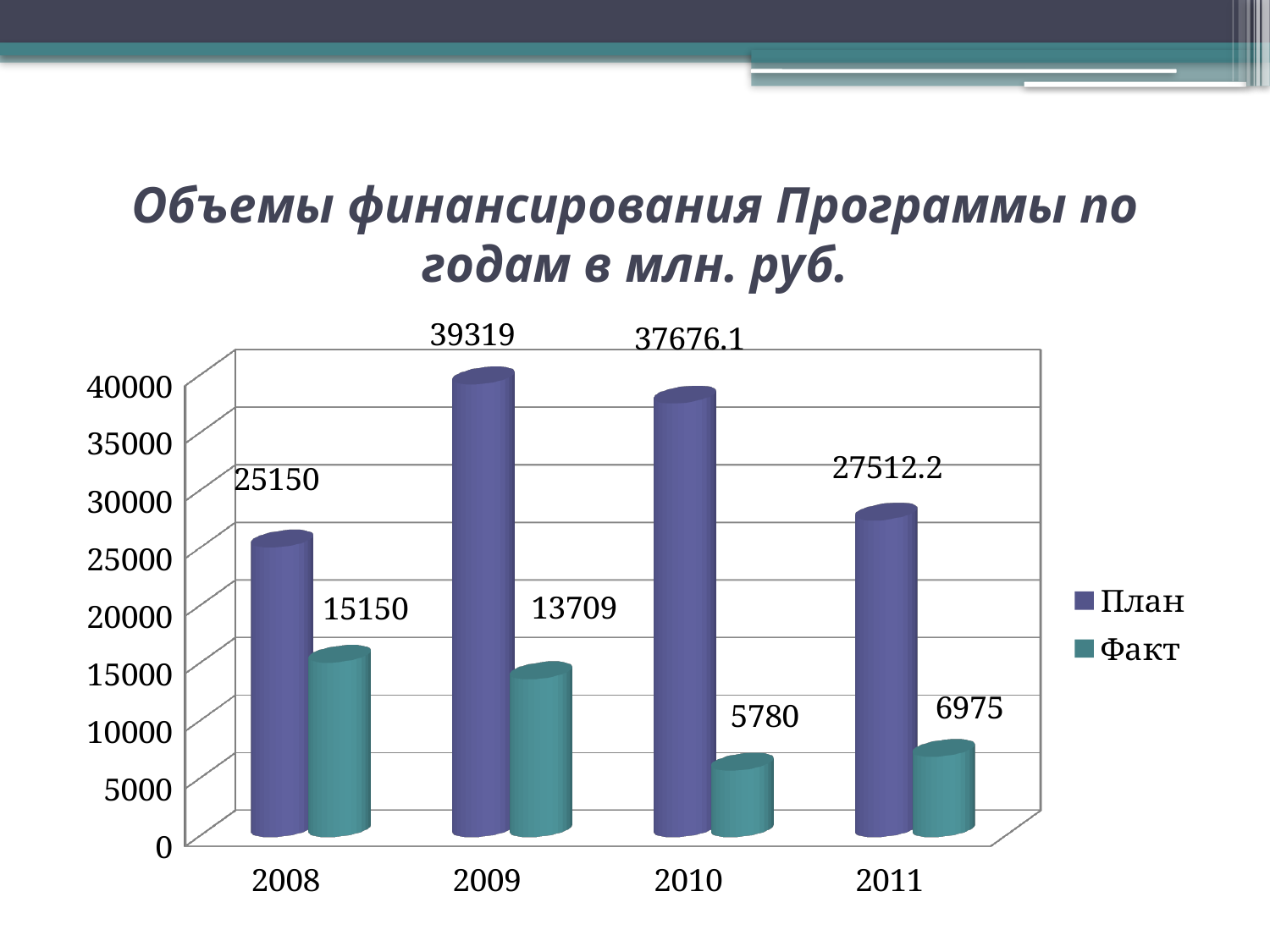
Which is larger, the Факт value for 2008 or the Факт value for 2009? 2008 How many series does the legend list? 2 What is the difference between the Факт values for 2011 and 2010? 1195 How many years are shown on the x axis? 4 Which year has the lowest Факт value? 2010 Which year has the highest План value? 2009 What is the План value for 2011? 27512.2 What is the difference between План and Факт in 2008? 10000 What is the Факт value for 2010? 5780 What is the title of the chart? Объемы финансирования Программы по годам в млн. руб. What is the План value for 2009? 39319 What kind of chart is shown on the slide? bar chart